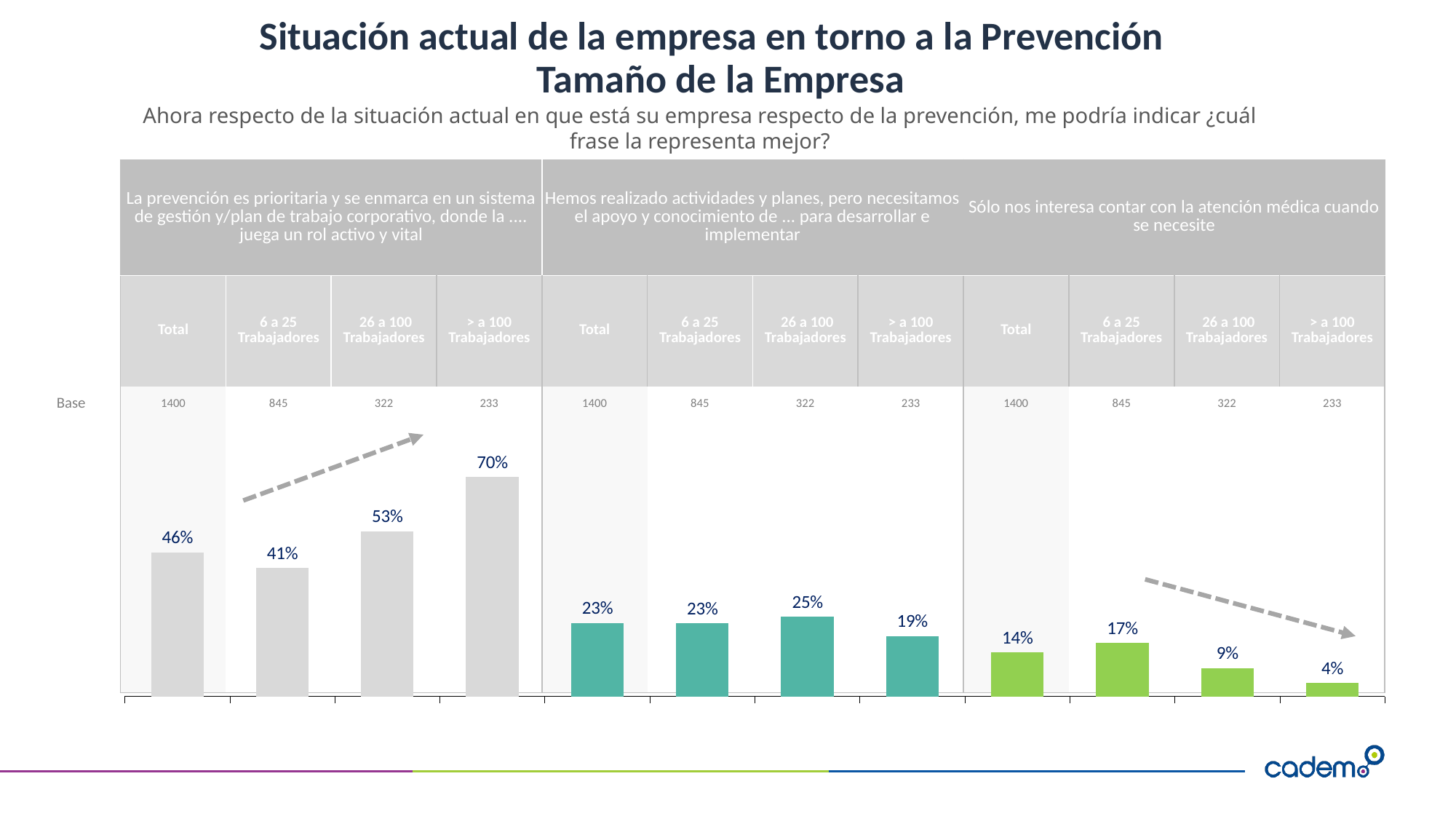
What is the value for '> a 100 Trabajadores' under the statement 'La prevención es prioritaria y se enmarca en un sistema de gestión...'? 70% Under 'Sólo nos interesa contar con la atención médica cuando se necesite', which is larger: the value for '6 a 25 Trabajadores' or for '26 a 100 Trabajadores'? 6 a 25 Trabajadores What is the Total value for the statement 'Hemos realizado actividades y planes, pero necesitamos el apoyo y conocimiento de ...'? 23% Which bar has the highest value in the chart? > a 100 Trabajadores (La prevención es prioritaria...), 70% Which bar has the lowest value in the chart? > a 100 Trabajadores (Sólo nos interesa contar con la atención médica...), 4% What is the difference between the Total values for 'La prevención es prioritaria...' and 'Hemos realizado actividades y planes...'? 23 percentage points What kind of chart is shown on the slide? bar chart How many bars are plotted in the chart? 12 Under 'Sólo nos interesa contar con la atención médica cuando se necesite', do the values rise or fall from '6 a 25 Trabajadores' to '> a 100 Trabajadores'? fall What is the value for '26 a 100 Trabajadores' under the statement 'Sólo nos interesa contar con la atención médica cuando se necesite'? 9% What is the difference between the '> a 100 Trabajadores' and '6 a 25 Trabajadores' values under 'La prevención es prioritaria...'? 29 percentage points What is the Base (sample size) shown for the '26 a 100 Trabajadores' group? 322